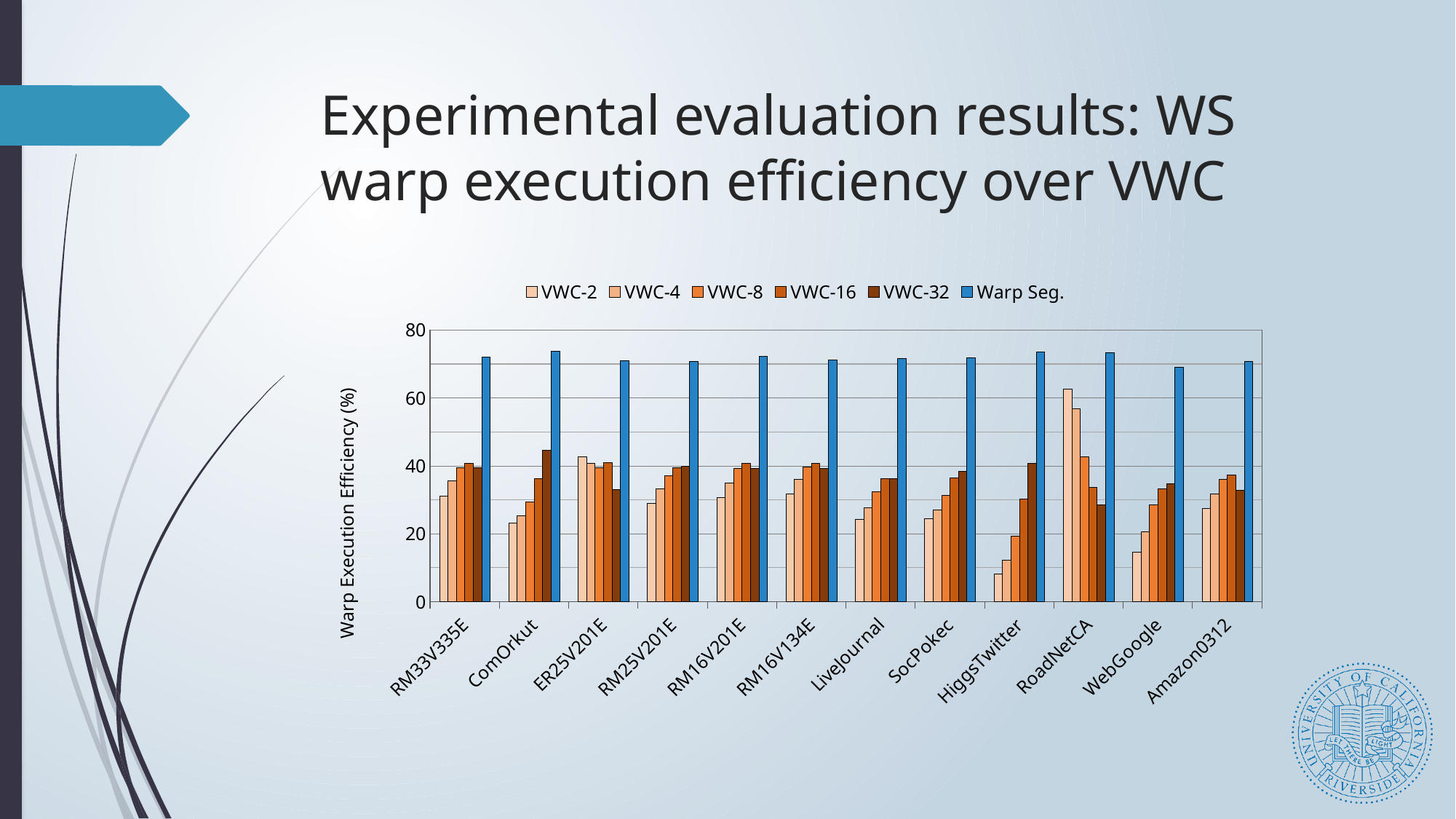
Which series is shown in blue in the legend? Warp Seg. What kind of chart is shown on the slide? bar chart Is the VWC-2 value for HiggsTwitter greater or less than 20? less Is the VWC-32 value for ComOrkut greater or less than 40? greater Is the Warp Seg. value for RM33V335E greater or less than 60? greater Which category has the lowest VWC-2 value? HiggsTwitter For LiveJournal, which is larger: the Warp Seg. value or the VWC-2 value? Warp Seg. How many series does the legend list? 6 Which category has the highest VWC-2 value? RoadNetCA What is the label of the y axis? Warp Execution Efficiency (%) How many categories (graphs) are shown along the x axis? 12